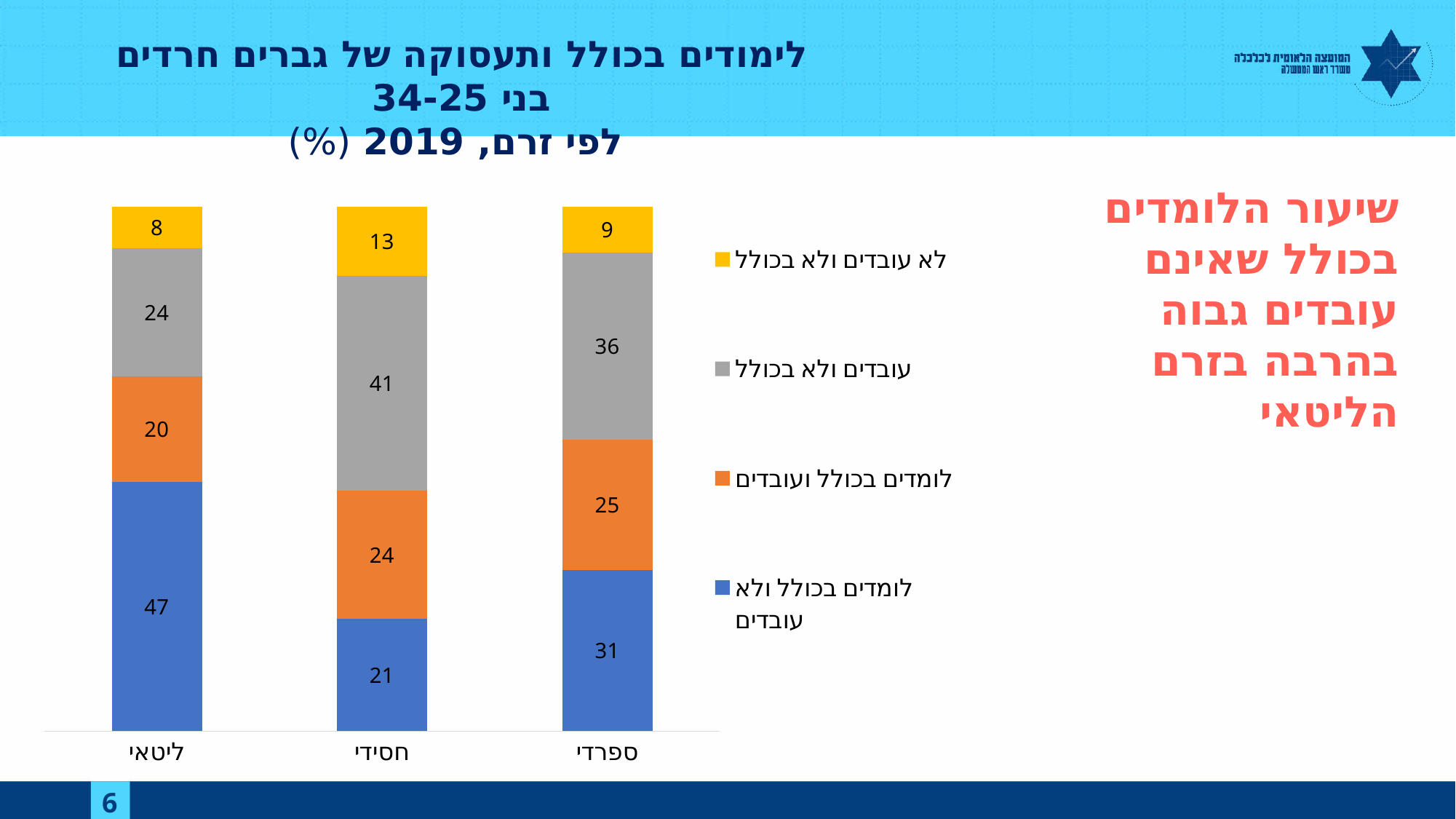
What is the value of עובדים ולא בכולל for חסידי? 41 What is the difference between the לומדים בכולל ולא עובדים values for ליטאי and חסידי? 26 Which is larger: the עובדים ולא בכולל value for ספרדי or for ליטאי? ספרדי Which stream has the lowest value for לא עובדים ולא בכולל? ליטאי How many categories (streams) are shown on the x axis of the chart? 3 What is the value of לא עובדים ולא בכולל for ספרדי? 9 Which stream has the highest value for לומדים בכולל ולא עובדים? ליטאי What type of chart is shown on the slide? stacked bar chart What is the total of the stacked bar for חסידי? 99 What is the value of לומדים בכולל ולא עובדים for ליטאי? 47 How many series does the chart's legend list? 4 What is the value of לומדים בכולל ועובדים for ספרדי? 25